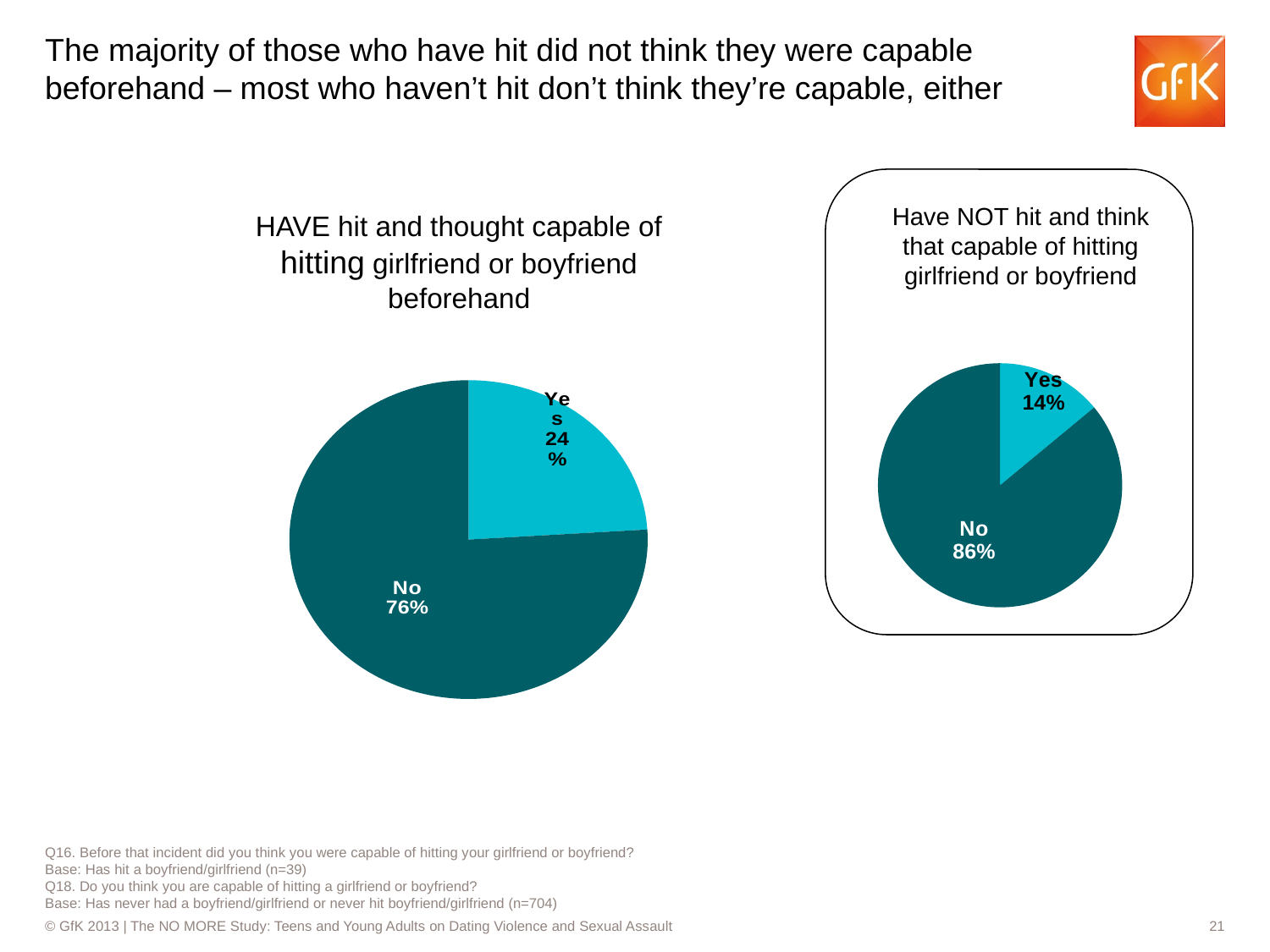
In the right pie chart (Have NOT hit and think that capable of hitting girlfriend or boyfriend), what percentage answered Yes? 14% What is the difference between the No and Yes percentages in the left pie chart? 52 percentage points In the left pie chart (HAVE hit and thought capable of hitting girlfriend or boyfriend beforehand), what percentage answered Yes? 24% In the right pie chart (Have NOT hit and think that capable of hitting girlfriend or boyfriend), what percentage answered No? 86% In the right pie chart, which slice is the smallest? Yes What is the difference between the No and Yes percentages in the right pie chart? 72 percentage points How many charts are shown on the slide? 2 In the left pie chart, which slice is the largest? No Which is larger: the Yes share in the left pie chart or the Yes share in the right pie chart? The left pie chart (24%) How many slices does the right pie chart have? 2 What type of chart is used on the left side of the slide? Pie chart In the left pie chart (HAVE hit and thought capable of hitting girlfriend or boyfriend beforehand), what percentage answered No? 76%